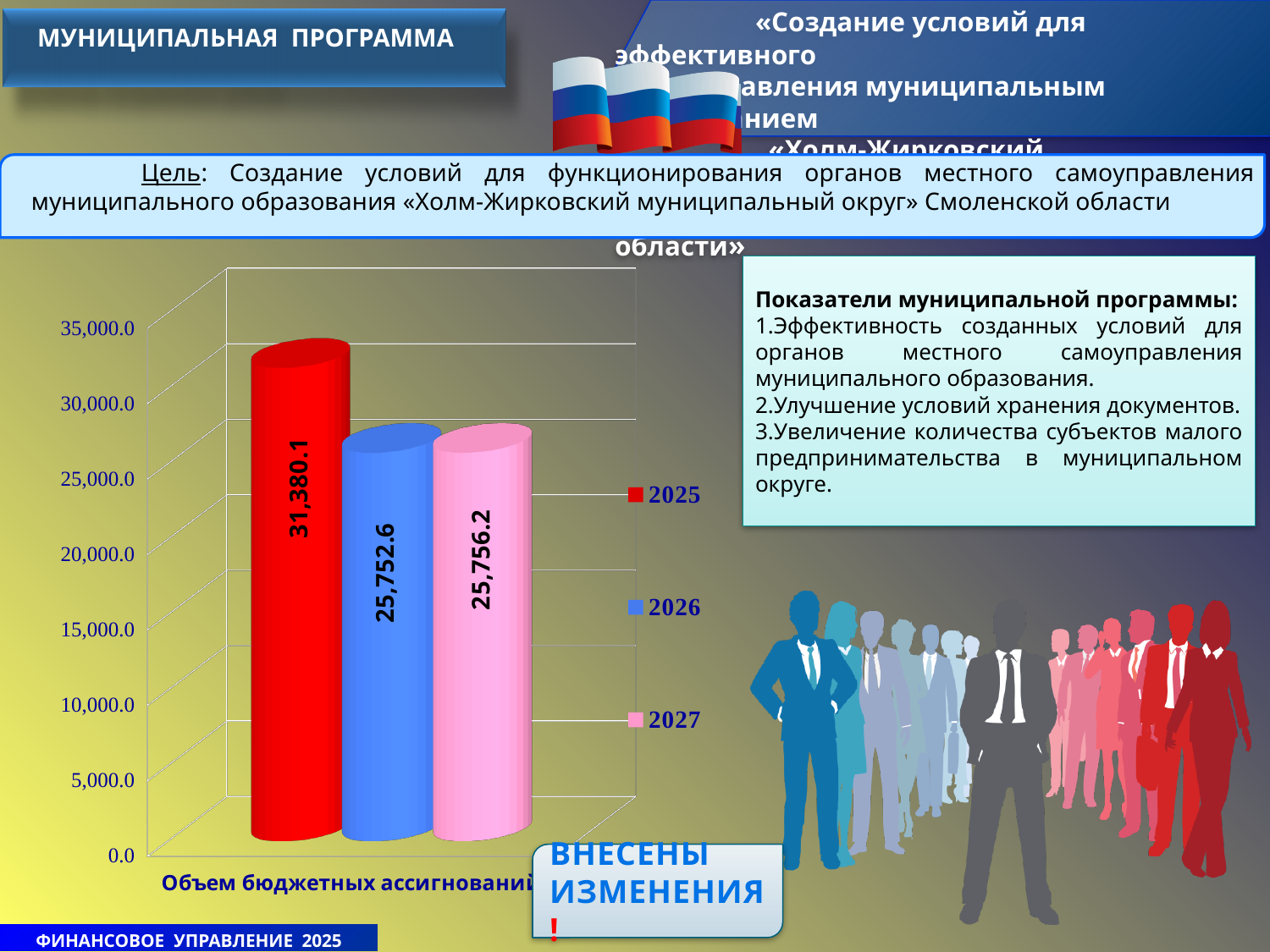
What kind of chart is shown on the slide? bar chart Is the value for 2026 greater or less than 30,000.0? less How many series does the legend list? 3 What is the difference between the values for 2025 and 2026? 5,627.5 Which year has the highest value in the chart? 2025 What is the value for 2025 in the chart? 31,380.1 What is the difference between the values for 2027 and 2026? 3.6 Is the value for 2025 greater or less than 30,000.0? greater Which is larger, the value for 2025 or the value for 2027? 2025 What is the value for 2026 in the chart? 25,752.6 What is the value for 2027 in the chart? 25,756.2 What is the category label shown under the bars? Объем бюджетных ассигнований